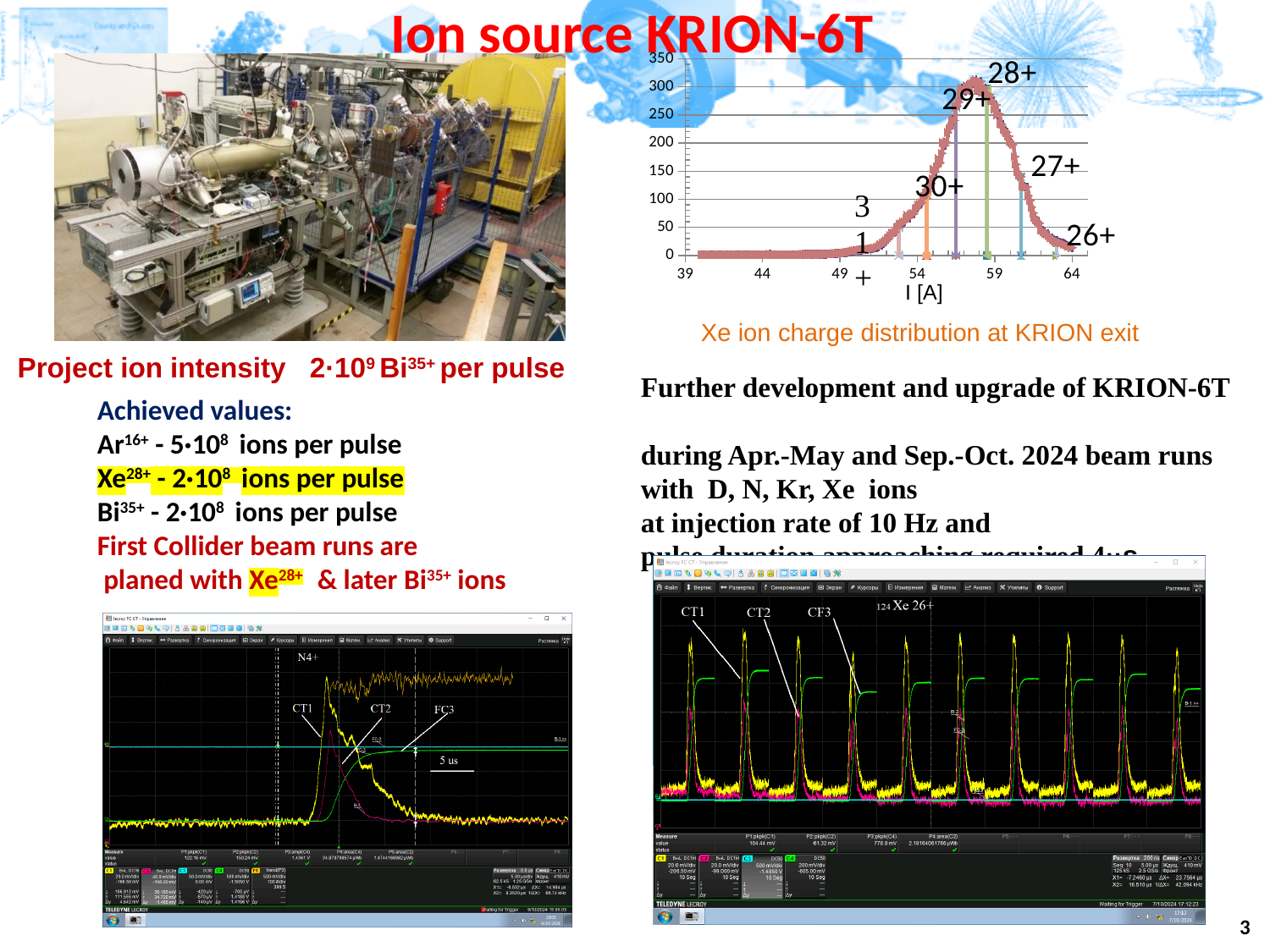
In the Xe ion charge distribution chart, how many charge states are labelled on the curve? 6 In the Xe ion charge distribution chart, is the value at the 26+ marker greater or less than 50? less In the Xe ion charge distribution chart, is the value at the 29+ marker greater or less than 200? greater What kind of chart is the 'Xe ion charge distribution at KRION exit' chart? line chart In the Xe ion charge distribution chart, is the value at the 28+ marker greater or less than 250? greater In the Xe ion charge distribution chart, which charge state is marked at the peak of the distribution? 28+ In the Xe ion charge distribution chart, what is the lowest tick value shown on the x axis? 39 In the Xe ion charge distribution chart, which has the larger value, the 28+ marker or the 26+ marker? 28+ In the Xe ion charge distribution chart, what is the highest tick value shown on the y axis? 350 In the Xe ion charge distribution chart, what is the label on the x axis? I [A] In the Xe ion charge distribution chart, does the curve rise or fall between I = 49 and I = 57? rise